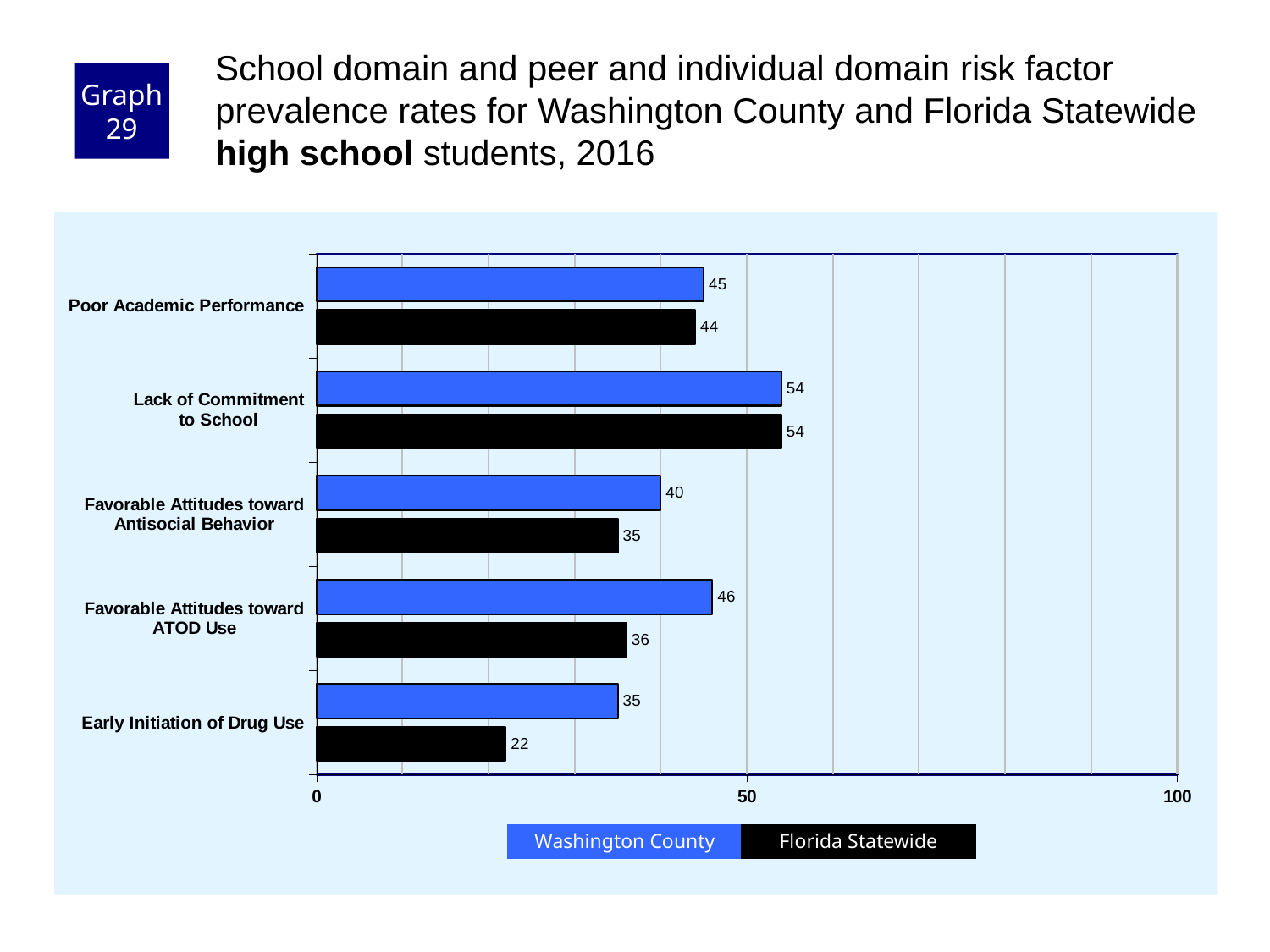
What is the Washington County value for Poor Academic Performance? 45 Is the Washington County value for Lack of Commitment to School greater or less than 50? greater How many risk factors are shown on the chart? 5 Which risk factor has the lowest Florida Statewide value? Early Initiation of Drug Use What is the difference between the Washington County and Florida Statewide values for Favorable Attitudes toward ATOD Use? 10 What is the Florida Statewide value for Favorable Attitudes toward ATOD Use? 36 What is the difference between the Washington County and Florida Statewide values for Early Initiation of Drug Use? 13 What is the Florida Statewide value for Early Initiation of Drug Use? 22 How many series does the legend list? 2 What kind of chart is shown on the slide? bar chart Which risk factor has the highest Washington County value? Lack of Commitment to School Which is larger for Favorable Attitudes toward Antisocial Behavior: the Washington County value or the Florida Statewide value? Washington County